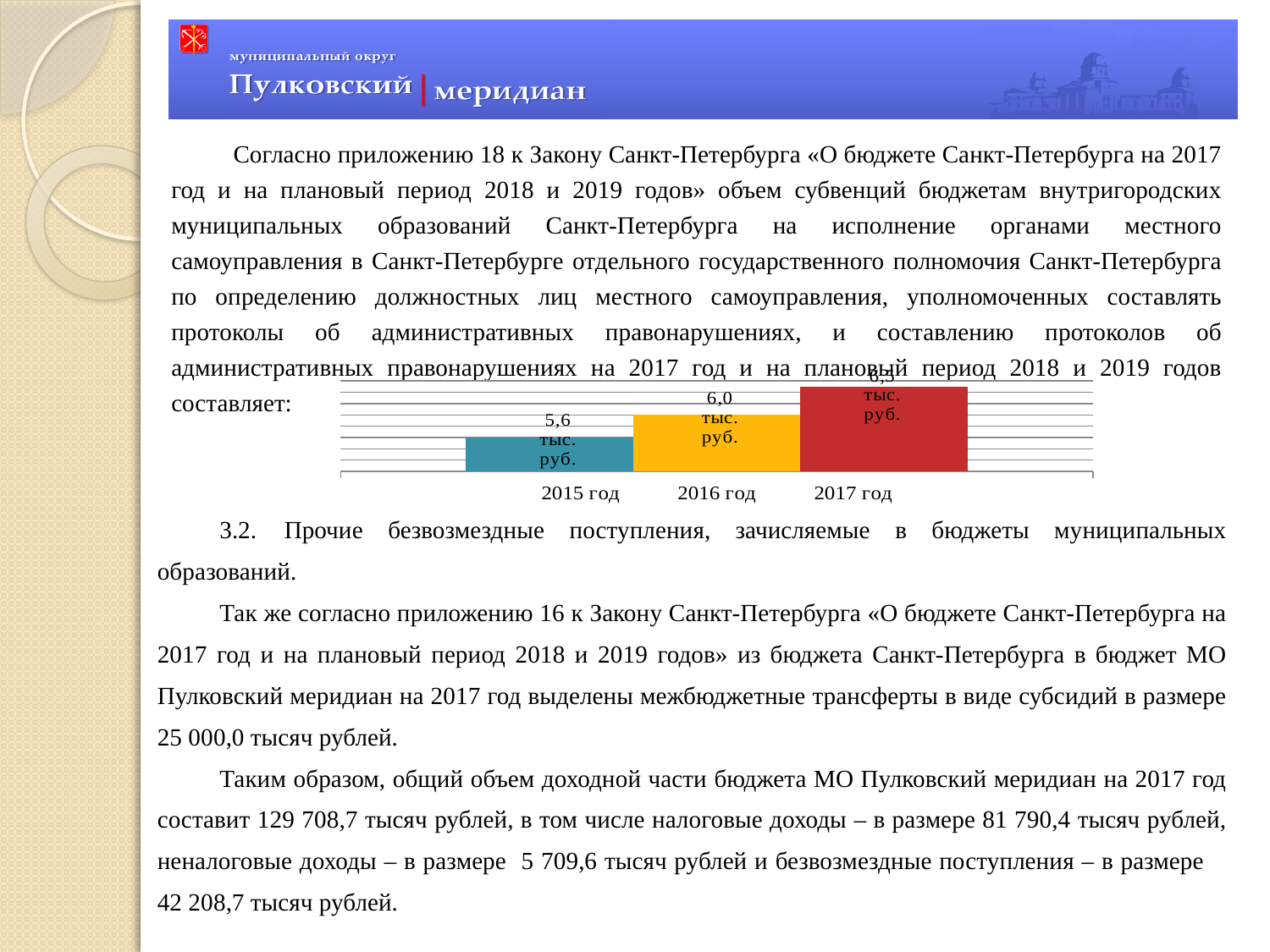
Which is larger, the value for 2016 год or the value for 2017 год? 2017 год What colour is the bar for 2017 год? red What is the value shown for 2016 год? 6,0 тыс. руб. What is the value shown for 2015 год? 5,6 тыс. руб. Which year has the highest bar in the chart? 2017 год What kind of chart is shown on the slide? bar chart How many bars (categories) does the chart show? 3 Which year has the lowest bar in the chart? 2015 год Which is larger, the value for 2015 год or the value for 2016 год? 2016 год What is the difference between the values for 2016 год and 2015 год? 0,4 тыс. руб. Do the values rise or fall from 2015 год to 2017 год? rise What colour is the bar for 2016 год? yellow